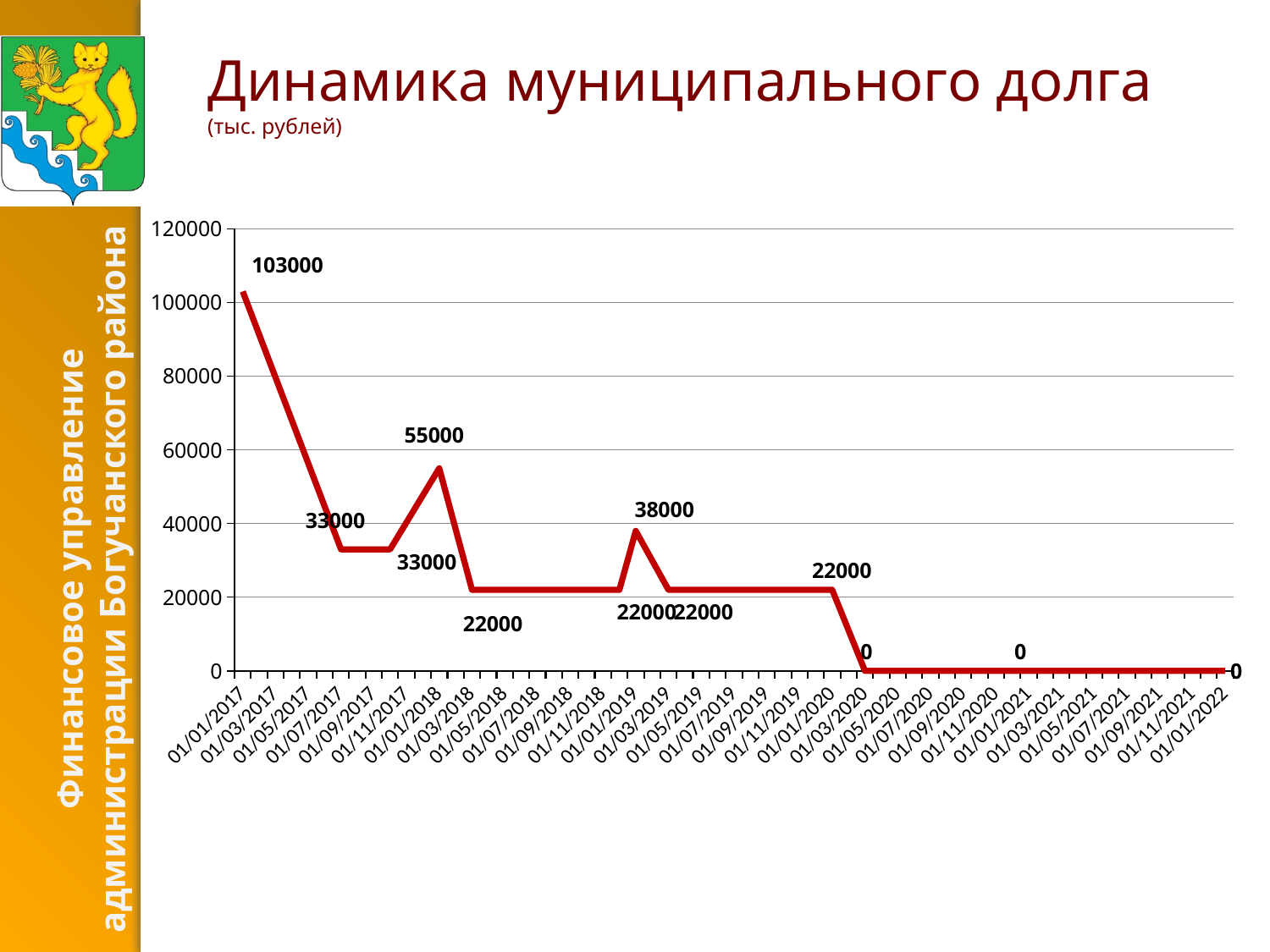
What is the value of municipal debt on 01/01/2022? 0 What is the title of the chart? Динамика муниципального долга On which date is the municipal debt highest? 01/01/2017 What is the value of municipal debt on 01/01/2019? 38000 What type of chart is shown on the slide? line chart What is the value of municipal debt on 01/01/2018? 55000 Which is larger, the debt on 01/01/2018 or on 01/01/2019? 01/01/2018 Overall, does the municipal debt rise or fall from 2017 to 2022? fall Is the value on 01/01/2017 greater or less than 100000? greater What is the value of municipal debt on 01/01/2017? 103000 What is the difference between the debt on 01/01/2018 and on 01/01/2019? 17000 What is the difference between the debt on 01/01/2017 and on 01/01/2018? 48000